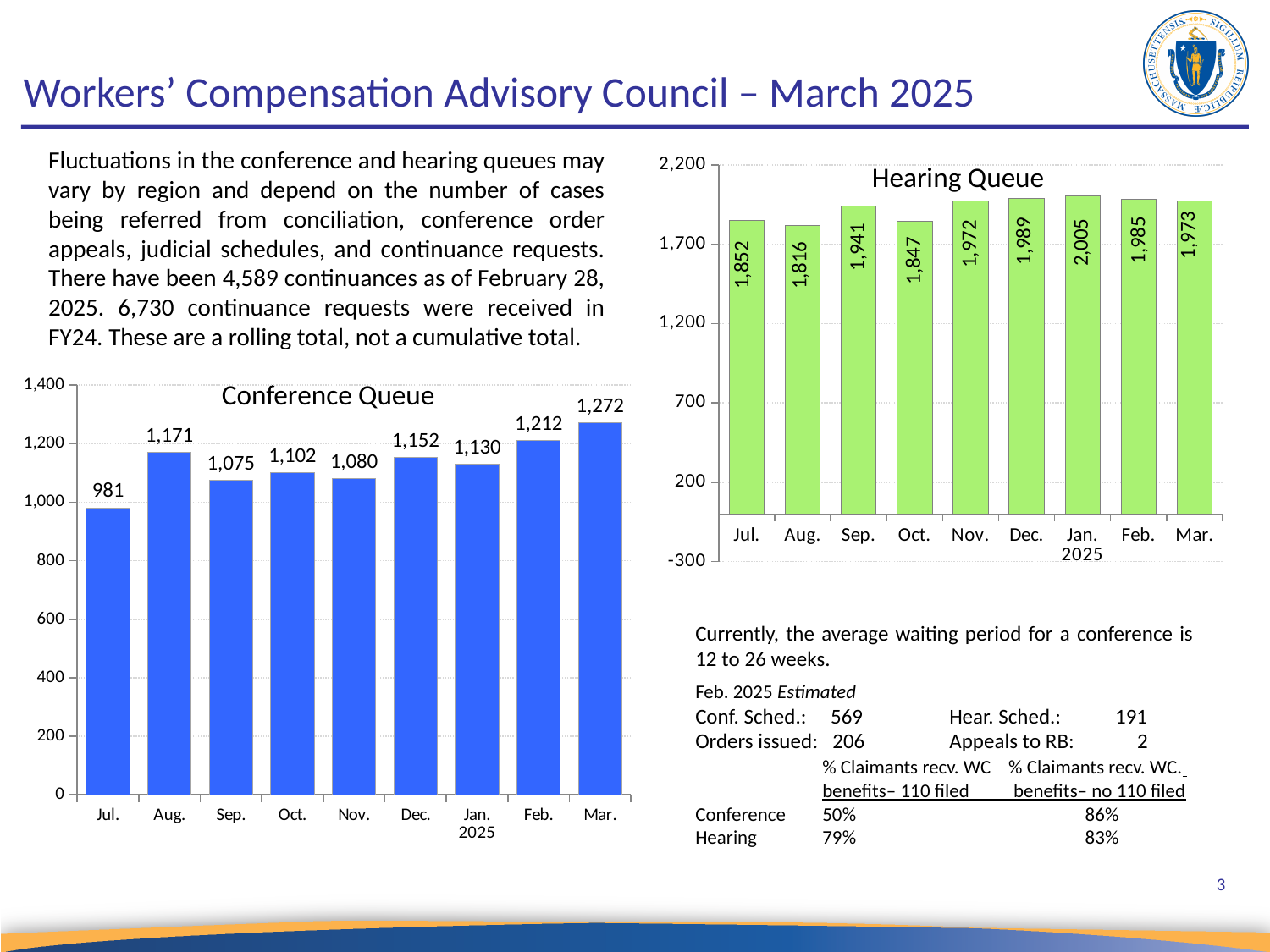
In the Conference Queue chart, how many months are plotted? 9 In the Conference Queue chart, is the value for Aug. greater or less than 1,000? greater In the Conference Queue chart, which month has the highest value? Mar. In the Conference Queue chart, what is the difference between the values for Mar. and Feb.? 60 In the Conference Queue chart, which month has the lowest value? Jul. In the Hearing Queue chart, what is the difference between the values for Nov. and Oct.? 125 In the Hearing Queue chart, which month has the highest value? Jan. 2025 What kind of chart is the Conference Queue chart? Bar chart In the Hearing Queue chart, what is the value for Jan. 2025? 2,005 In the Hearing Queue chart, which month has the lowest value? Aug. In the Conference Queue chart, what is the value for Jul.? 981 In the Hearing Queue chart, which is larger, the value for Sep. or the value for Oct.? Sep.